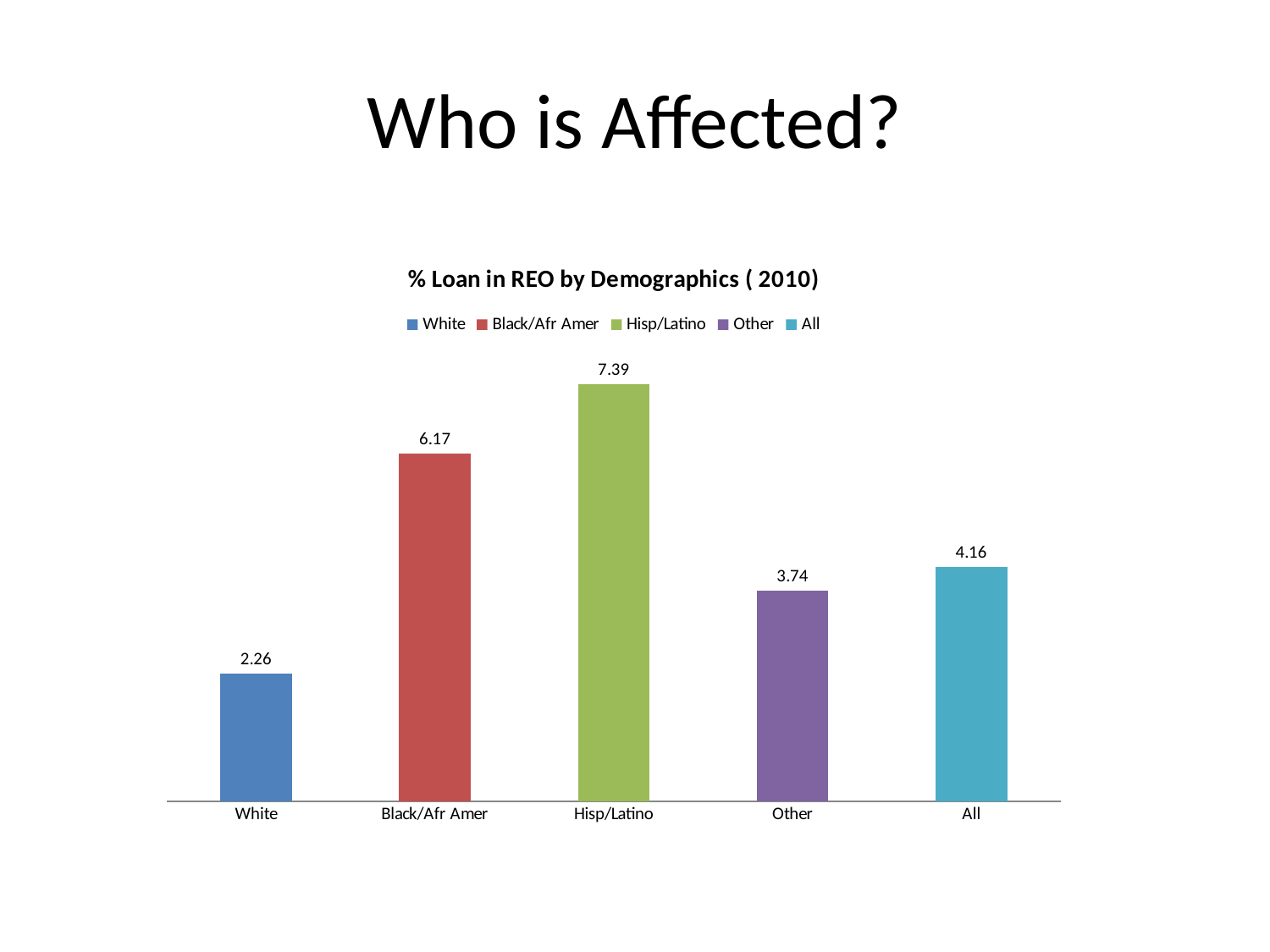
What is the value for Hisp/Latino? 7.39 How many entries does the legend list? 5 What is the value for All? 4.16 Which category has the lowest value? White What kind of chart is shown? bar chart How many categories are shown on the x axis? 5 What is the difference between the values for Hisp/Latino and Black/Afr Amer? 1.22 Which category has the highest value? Hisp/Latino Which is larger, the value for Other or the value for All? All What is the title of the chart? % Loan in REO by Demographics ( 2010) What is the value for White? 2.26 What is the difference between the values for All and White? 1.90